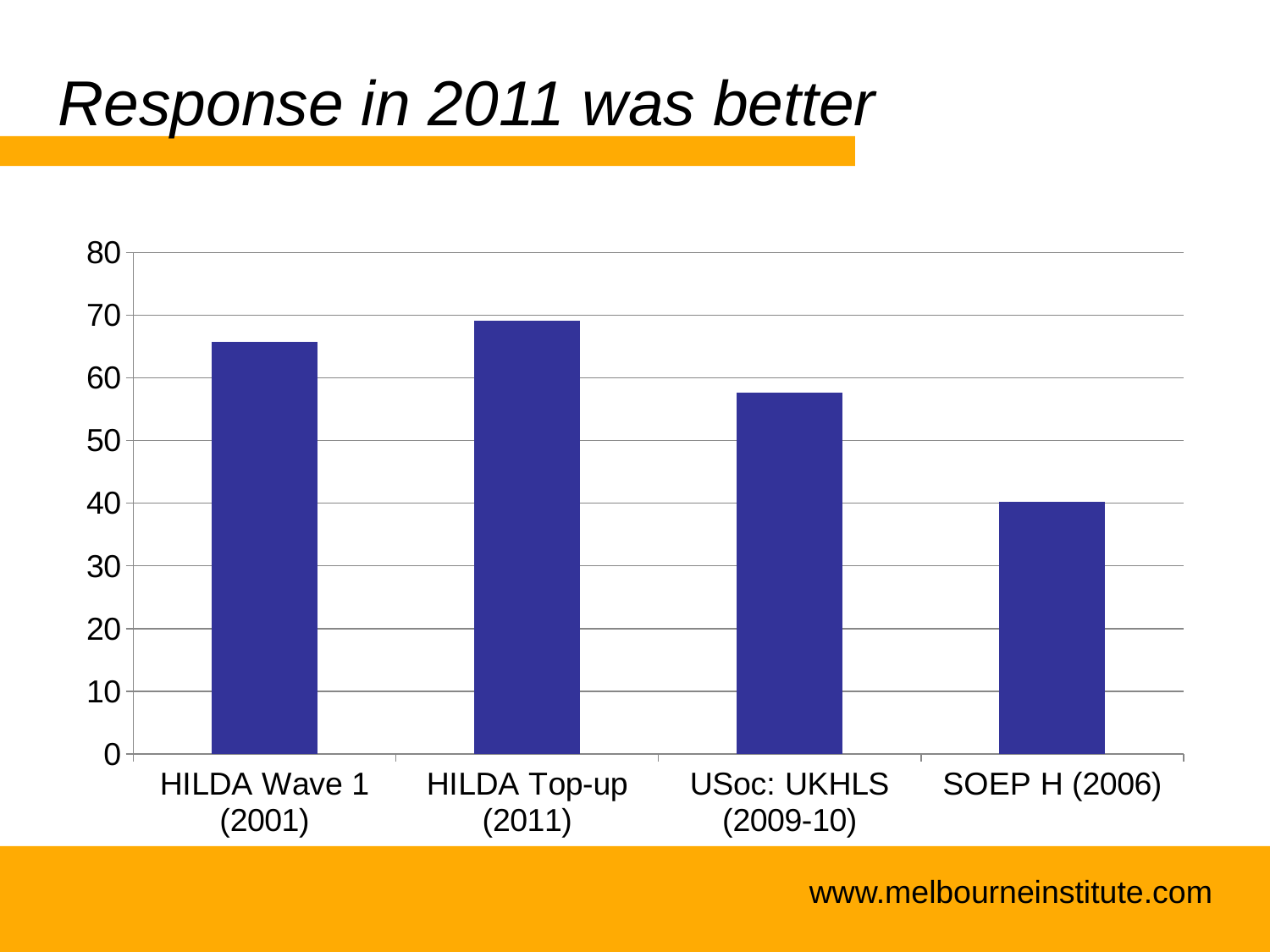
Which category has the highest bar? HILDA Top-up (2011) How many categories are shown on the x axis of the chart? 4 What kind of chart is shown on the slide? bar chart What is the highest value shown on the y axis of the chart? 80 What is the title of the slide containing the chart? Response in 2011 was better Which is larger, the value for HILDA Wave 1 (2001) or the value for USoc: UKHLS (2009-10)? HILDA Wave 1 (2001) Is the value for USoc: UKHLS (2009-10) greater or less than 50? greater Is the value for HILDA Wave 1 (2001) greater or less than 60? greater Is the value for SOEP H (2006) greater or less than 50? less Which category has the lowest bar? SOEP H (2006) Which is larger, the value for HILDA Top-up (2011) or the value for SOEP H (2006)? HILDA Top-up (2011)